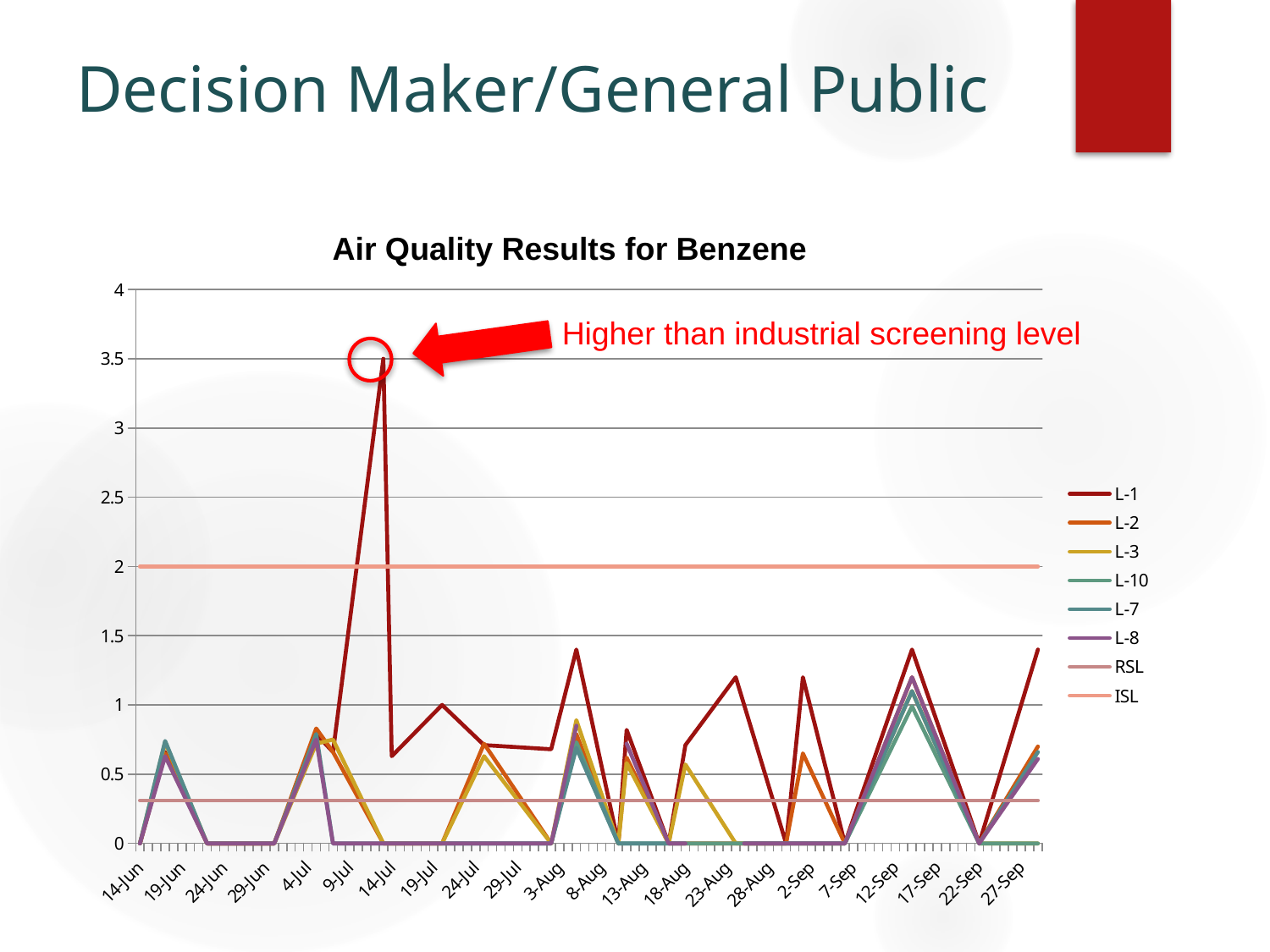
How many date labels are shown on the x axis? 22 Is the value of the RSL line greater or less than 0.5? less What kind of chart is shown on the slide? line chart What is the last date label on the x axis? 27-Sep What is the first date label on the x axis? 14-Jun What is the title of the chart? Air Quality Results for Benzene Which horizontal reference line is higher, ISL or RSL? ISL At what value does the horizontal ISL line sit? 2 How many series does the legend list? 8 Which series reaches the highest value on the chart? L-1 Is the peak value of L-1 greater or less than 3? greater What does the red annotation text next to the arrow say? Higher than industrial screening level